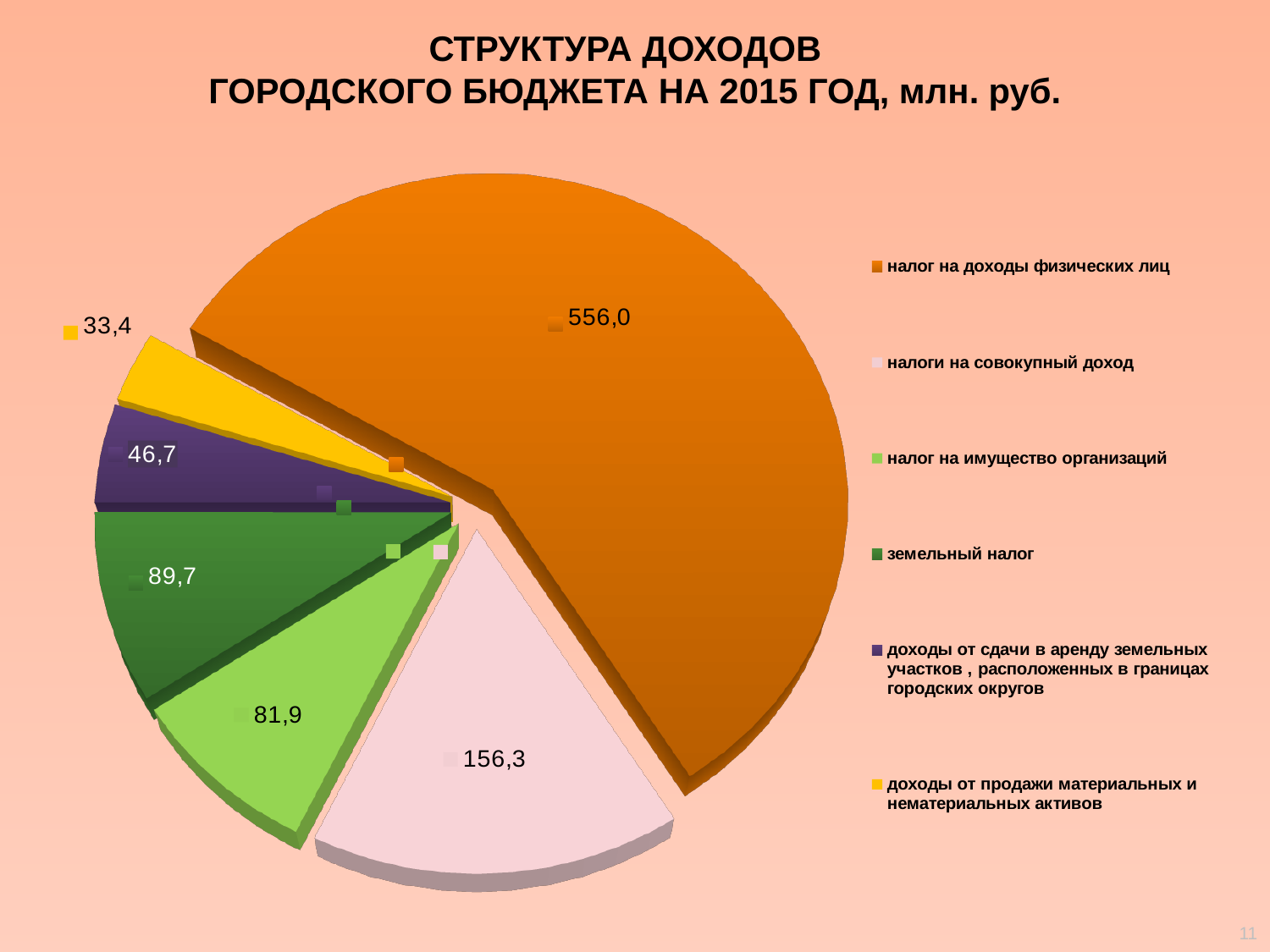
Which category has the smallest slice of the pie? доходы от продажи материальных и нематериальных активов How many slices does the pie chart have? 6 Which is larger: земельный налог or налог на имущество организаций? земельный налог What colour is the slice for налог на доходы физических лиц? orange What is the value for доходы от продажи материальных и нематериальных активов? 33,4 What is the total of all the values shown in the pie chart? 964,0 Which category has the largest slice of the pie? налог на доходы физических лиц What kind of chart is shown on the slide? pie chart What is the value for земельный налог? 89,7 What is the difference between the values for налог на доходы физических лиц and налоги на совокупный доход? 399,7 What is the value for налог на доходы физических лиц? 556,0 What is the value for налоги на совокупный доход? 156,3